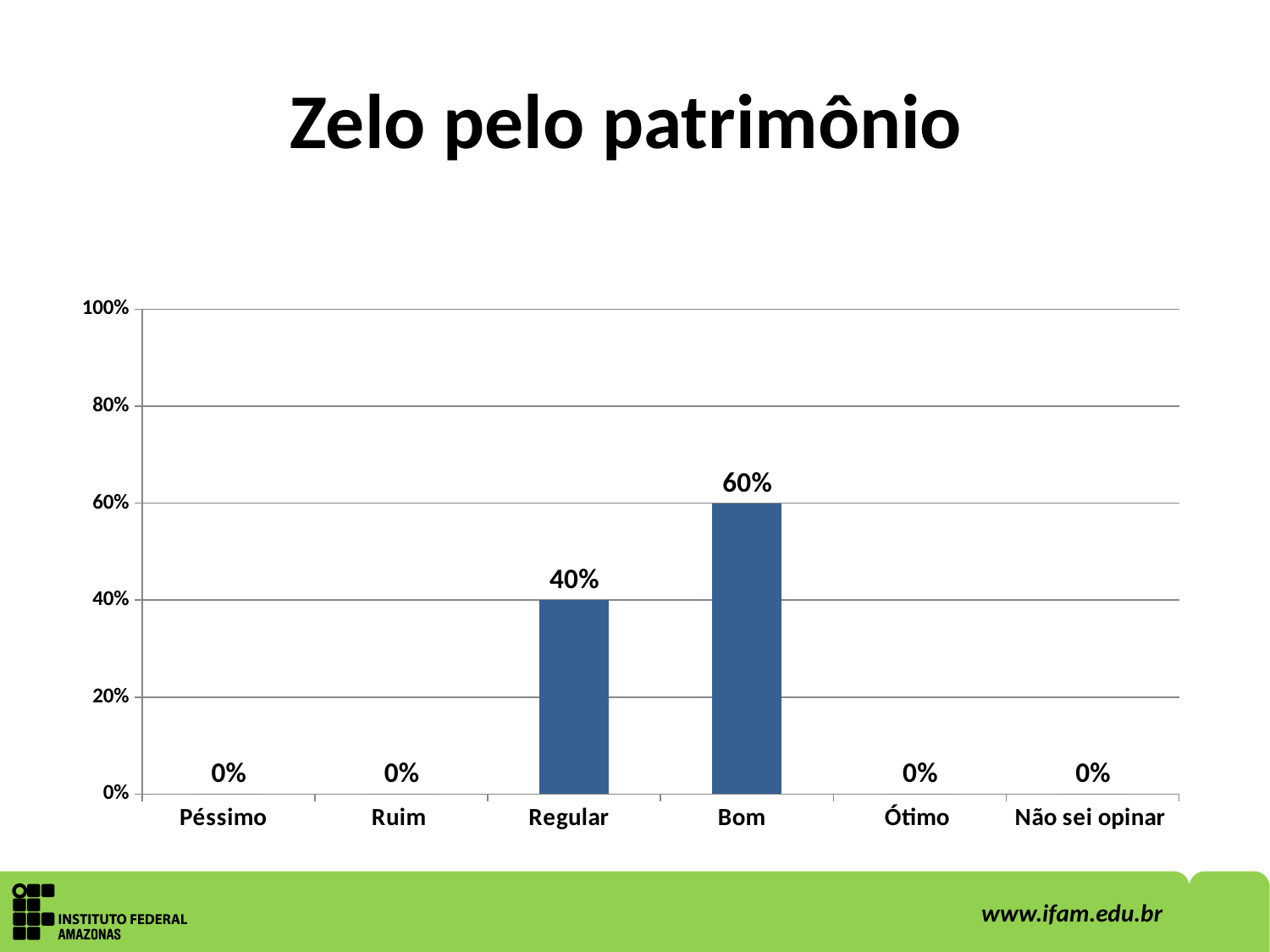
What is the value for Bom? 60% What is the title of the slide? Zelo pelo patrimônio What is the value for Regular? 40% What is the value for Ótimo? 0% How many categories have a value of 0%? 4 Which is larger, the value for Regular or the value for Bom? Bom What is the difference between the values for Bom and Regular? 20% How many categories are shown on the x axis? 6 Which category has the highest value? Bom What is the highest value shown on the y axis? 100% What kind of chart is shown on the slide? bar chart Is the value for Bom greater or less than 50%? greater